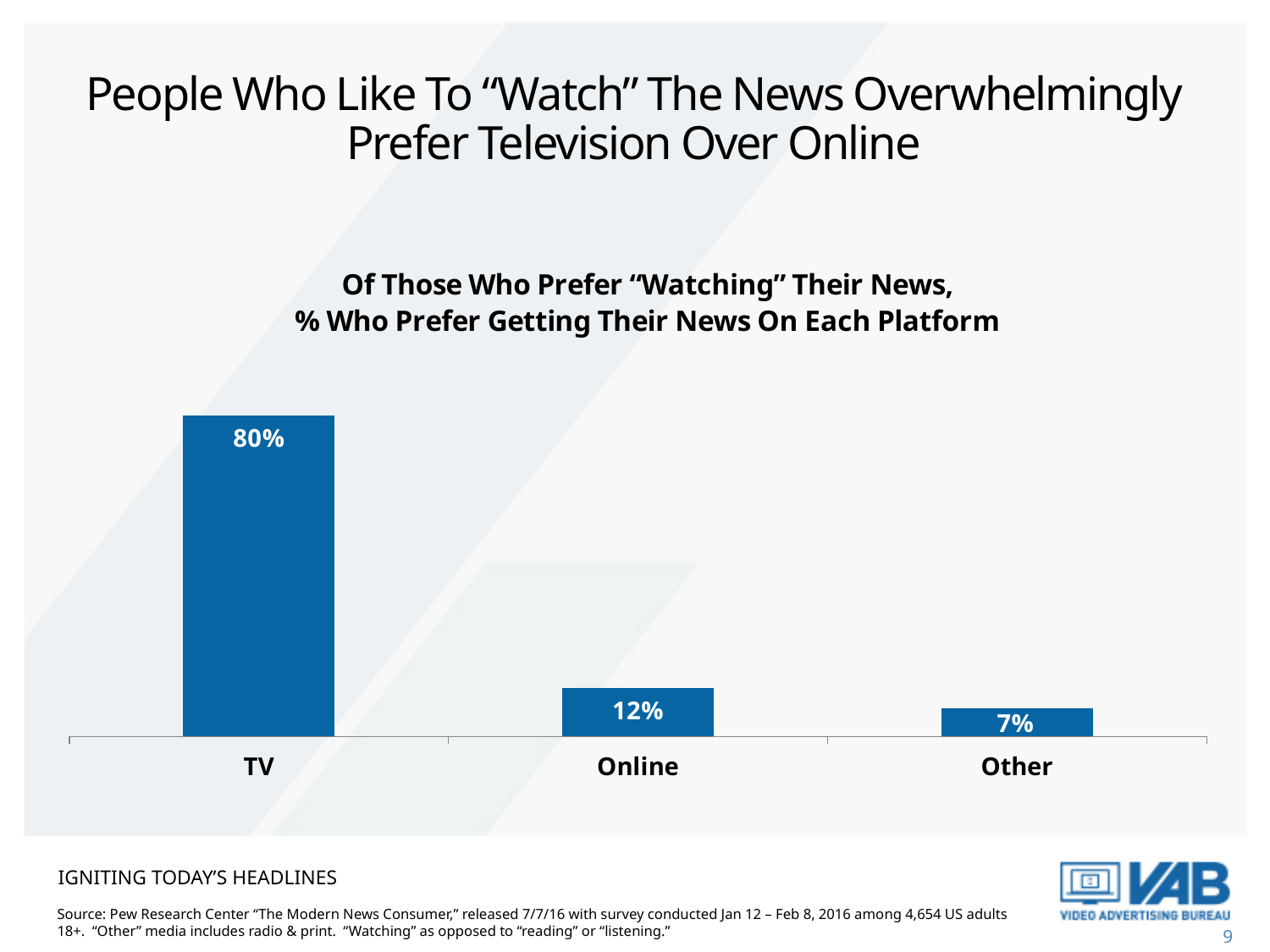
What is the difference in percentage points between TV and Online? 68 How many platforms are shown on the chart? 3 Which platform has the lowest percentage? Other Which platform has the highest percentage? TV What is the title of the chart? Of Those Who Prefer "Watching" Their News, % Who Prefer Getting Their News On Each Platform What percentage of those who prefer watching their news prefer getting it on TV? 80% What is the difference in percentage points between Online and Other? 5 What is the value shown for Online? 12% Do the values rise or fall moving from TV to Other along the x axis? Fall Which is larger, the value for Online or the value for Other? Online What is the value shown for Other? 7% What kind of chart is shown on the slide? Bar chart